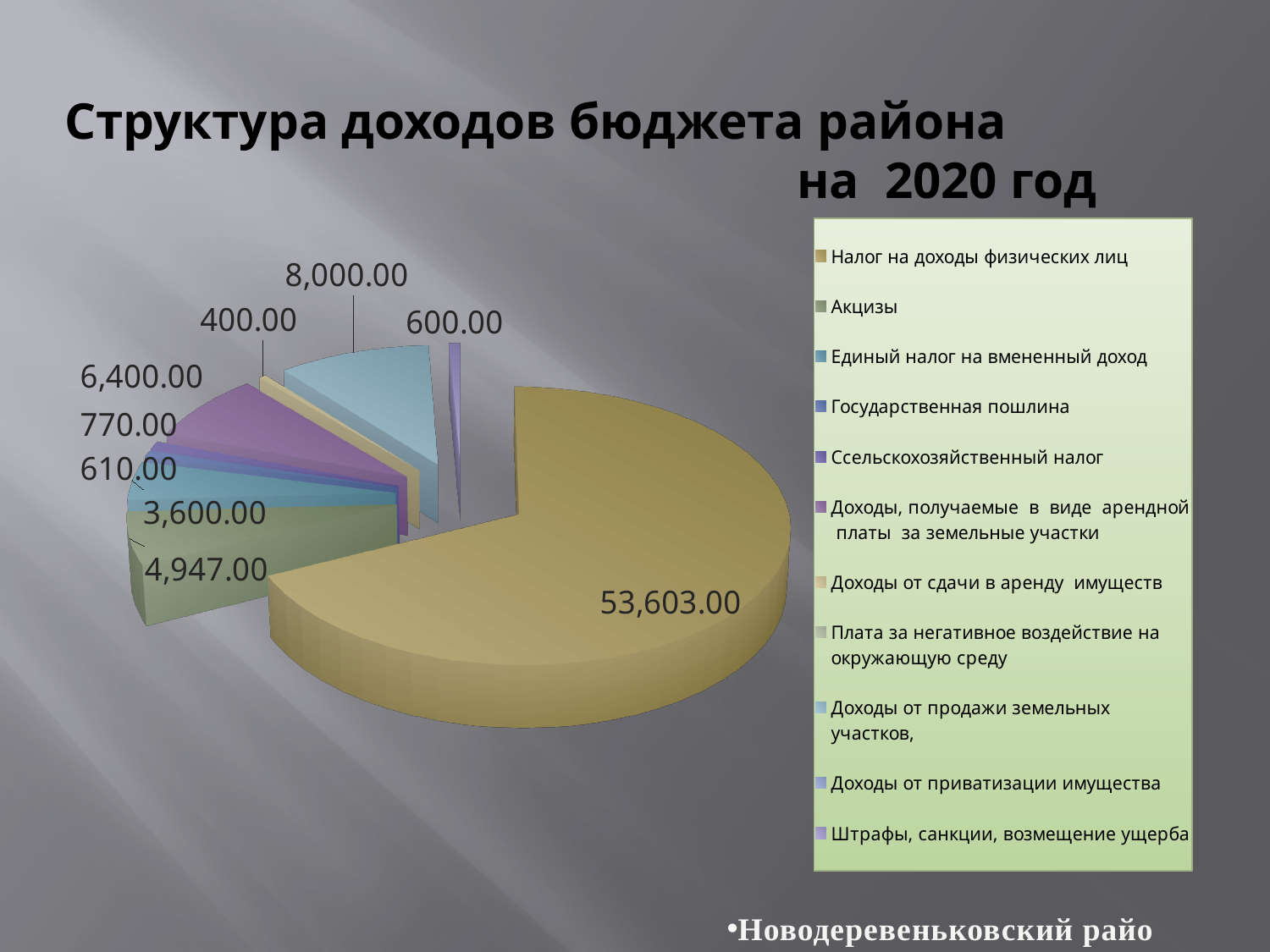
What colour is the largest slice of the pie? gold What is the difference between the value for Доходы от продажи земельных участков (8,000.00) and the value for Доходы, получаемые в виде арендной платы за земельные участки (6,400.00)? 1,600.00 What kind of chart is shown on the slide? pie chart What is the value shown for Единый налог на вмененный доход? 3,600.00 What is the value shown for Акцизы? 4,947.00 What is the difference between the value for Налог на доходы физических лиц and the value for Акцизы? 48,656.00 What is the value shown for Доходы от продажи земельных участков? 8,000.00 Which is larger: the slice for Акцизы or the slice for Единый налог на вмененный доход? Акцизы What is the value shown for the largest slice, Налог на доходы физических лиц? 53,603.00 What is the title of the chart? Структура доходов бюджета района на 2020 год How many entries does the legend list? 11 Which category has the largest slice of the pie? Налог на доходы физических лиц